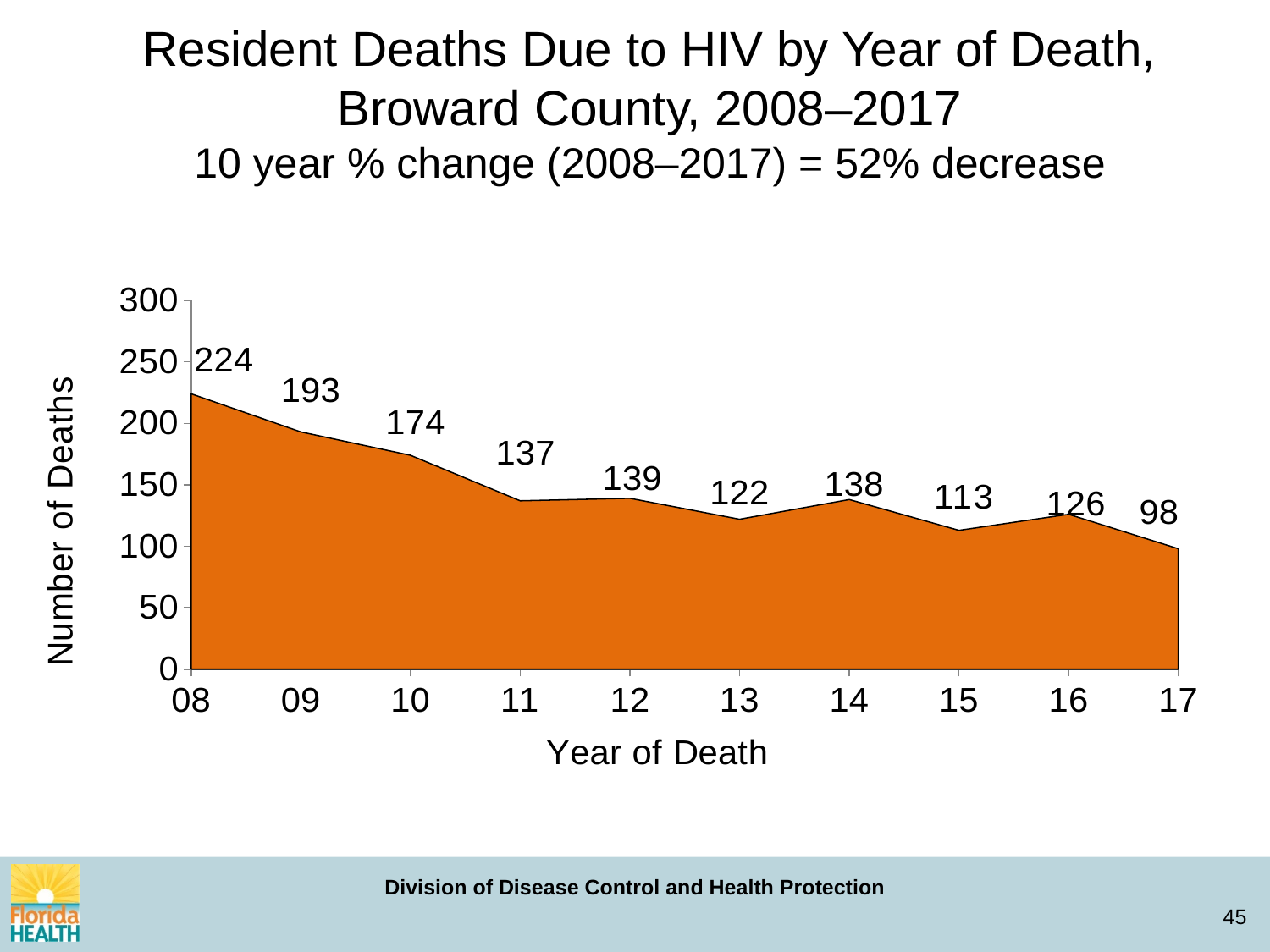
Which year had more deaths, 12 or 14? 12 Do the values generally rise or fall from 2008 to 2017? Fall What is the difference in deaths between 2008 and 2017? 126 What is the number of deaths shown for year 17? 98 What is the label of the y axis? Number of Deaths How many resident deaths due to HIV were there in 2008? 224 Is the value for year 15 greater or less than 150? less Which year has the lowest number of deaths? 17 What kind of chart is shown? Area chart What is the number of deaths shown for year 13? 122 Which year has the highest number of deaths? 08 How many years are plotted on the x axis? 10